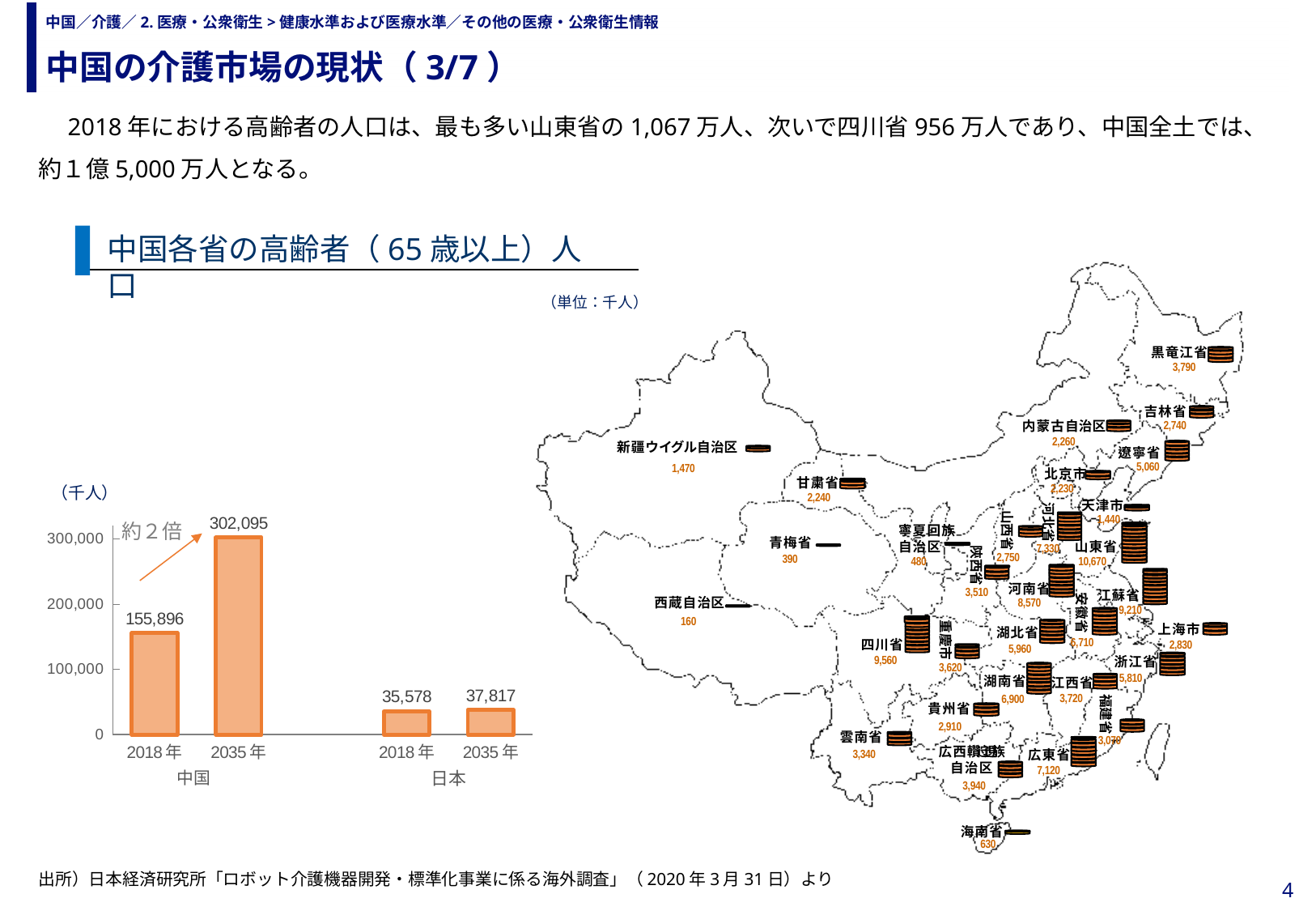
In the bar chart on the left, how many bars are plotted? 4 What kind of chart is shown on the left of the slide? bar chart In the bar chart on the left, what unit is shown on the vertical axis? 千人 In the bar chart on the left, which bar is the highest? 中国 2035年 In the bar chart on the left, what is the value for 日本 in 2018年? 35,578 In the bar chart on the left, what is the difference between the 日本 2035年 value and the 日本 2018年 value? 2,239 In the bar chart on the left, what is the difference between the 中国 2035年 value and the 中国 2018年 value? 146,199 In the bar chart on the left, what is the value for 中国 in 2035年? 302,095 In the bar chart on the left, what is the value for 日本 in 2035年? 37,817 In the bar chart on the left, which bar is the lowest? 日本 2018年 On the map on the right, what is the value shown for 山東省? 10,670 In the bar chart on the left, what is the value for 中国 in 2018年? 155,896